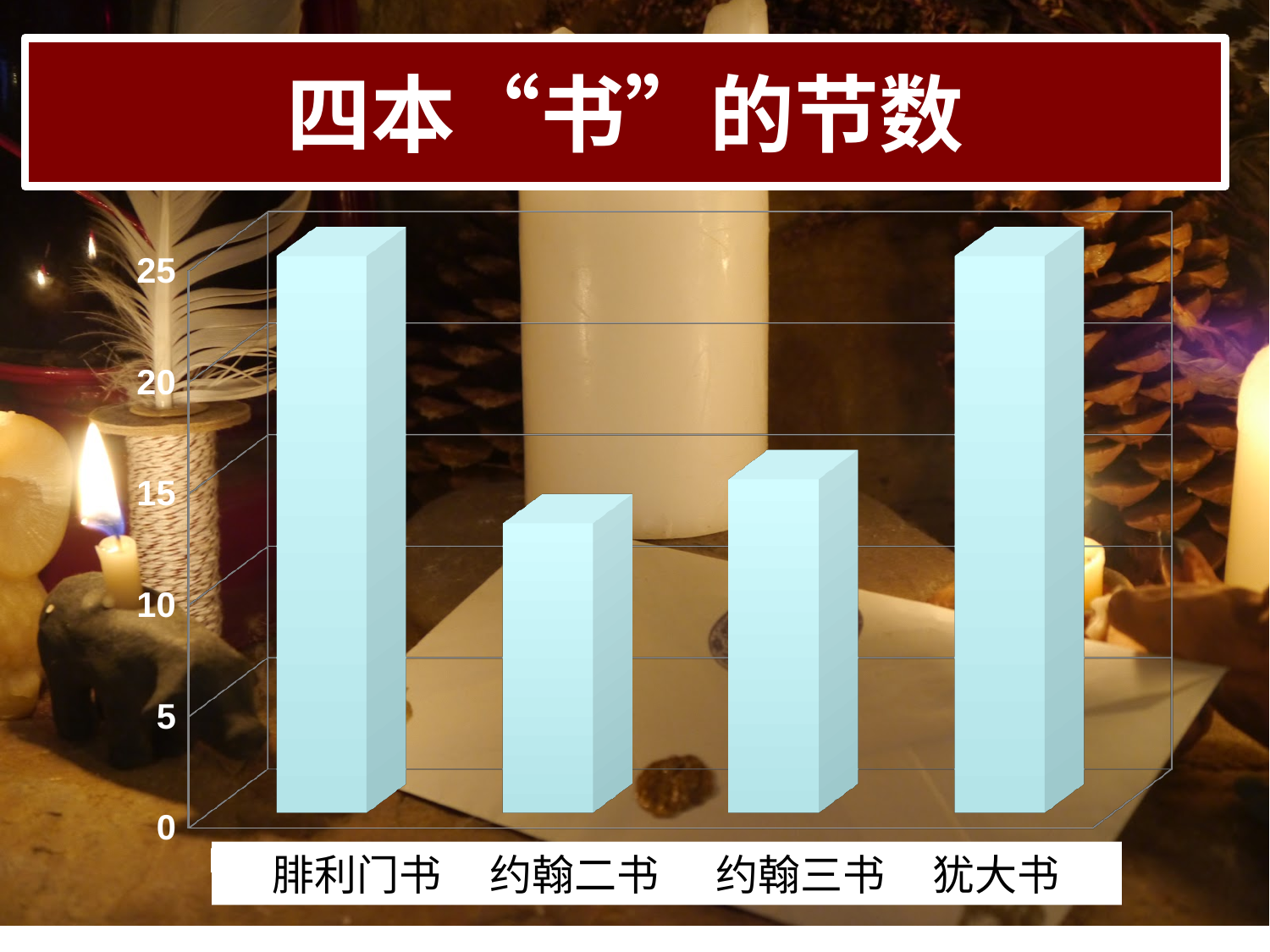
Is the value for 约翰二书 greater or less than 15? less What kind of chart is shown on the slide? bar chart What is the title of the chart? 四本“书”的节数 Which is larger, the value for 犹大书 or the value for 约翰三书? 犹大书 How many categories (books) are shown on the x axis of the chart? 4 Is the value for 约翰三书 greater or less than 10? greater Which is larger, the value for 约翰二书 or the value for 约翰三书? 约翰三书 Which book has the lowest bar in the chart? 约翰二书 Which is larger, the value for 腓利门书 or the value for 约翰二书? 腓利门书 Is the value for 腓利门书 greater or less than 20? greater